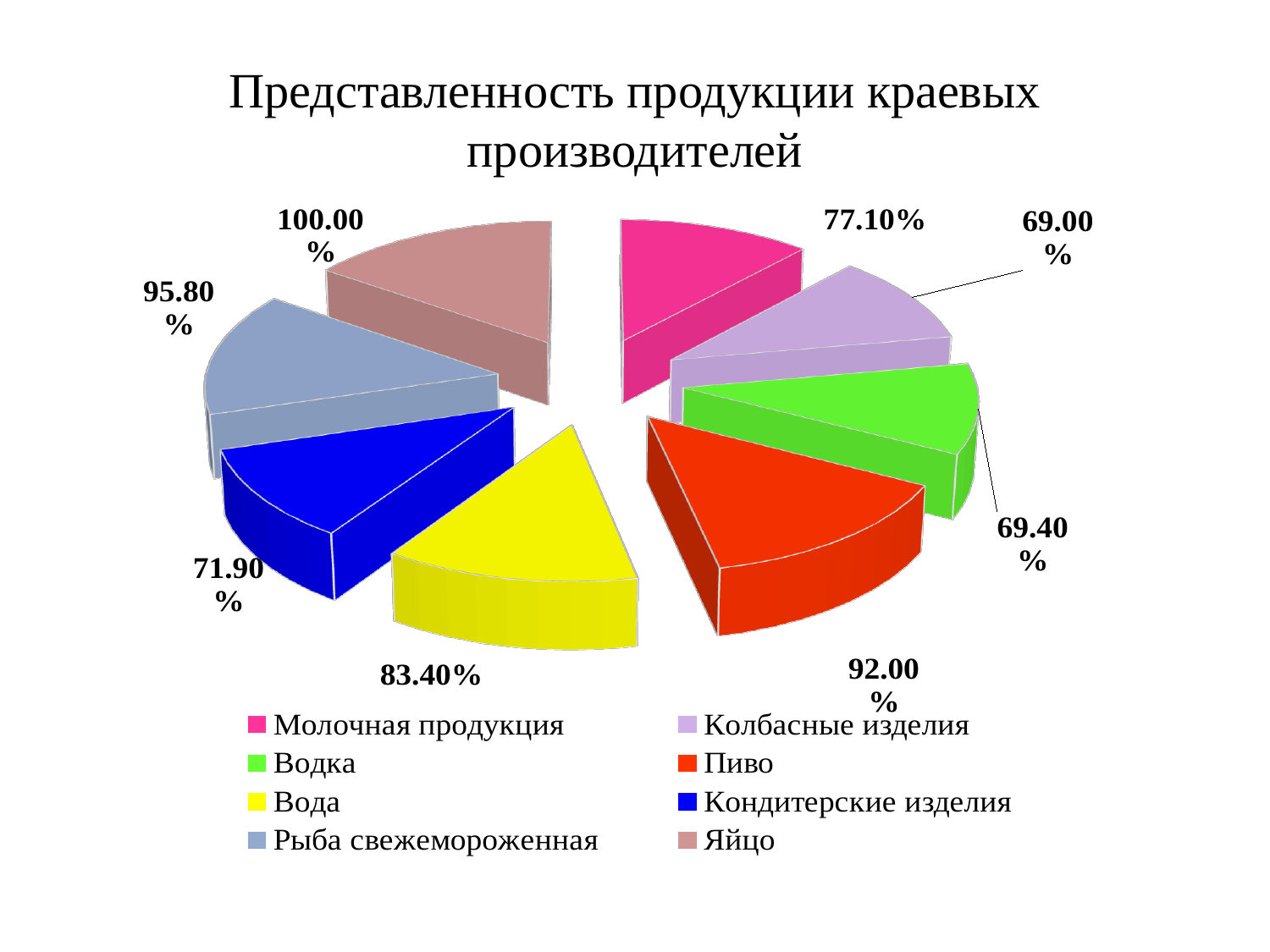
What is the difference between the values for Яйцо and Колбасные изделия? 31.00% Which category has the highest value? Яйцо What type of chart is shown on the slide? pie chart What is the value shown for Рыба свежемороженная? 95.80% What is the value shown for Вода? 83.40% What is the value shown for Молочная продукция? 77.10% Which is larger, the value for Пиво or the value for Вода? Пиво How many categories does the pie chart have? 8 Which category has the lowest value? Колбасные изделия What is the title of the chart? Представленность продукции краевых производителей What is the value shown for Кондитерские изделия? 71.90% What is the value shown for Пиво? 92.00%